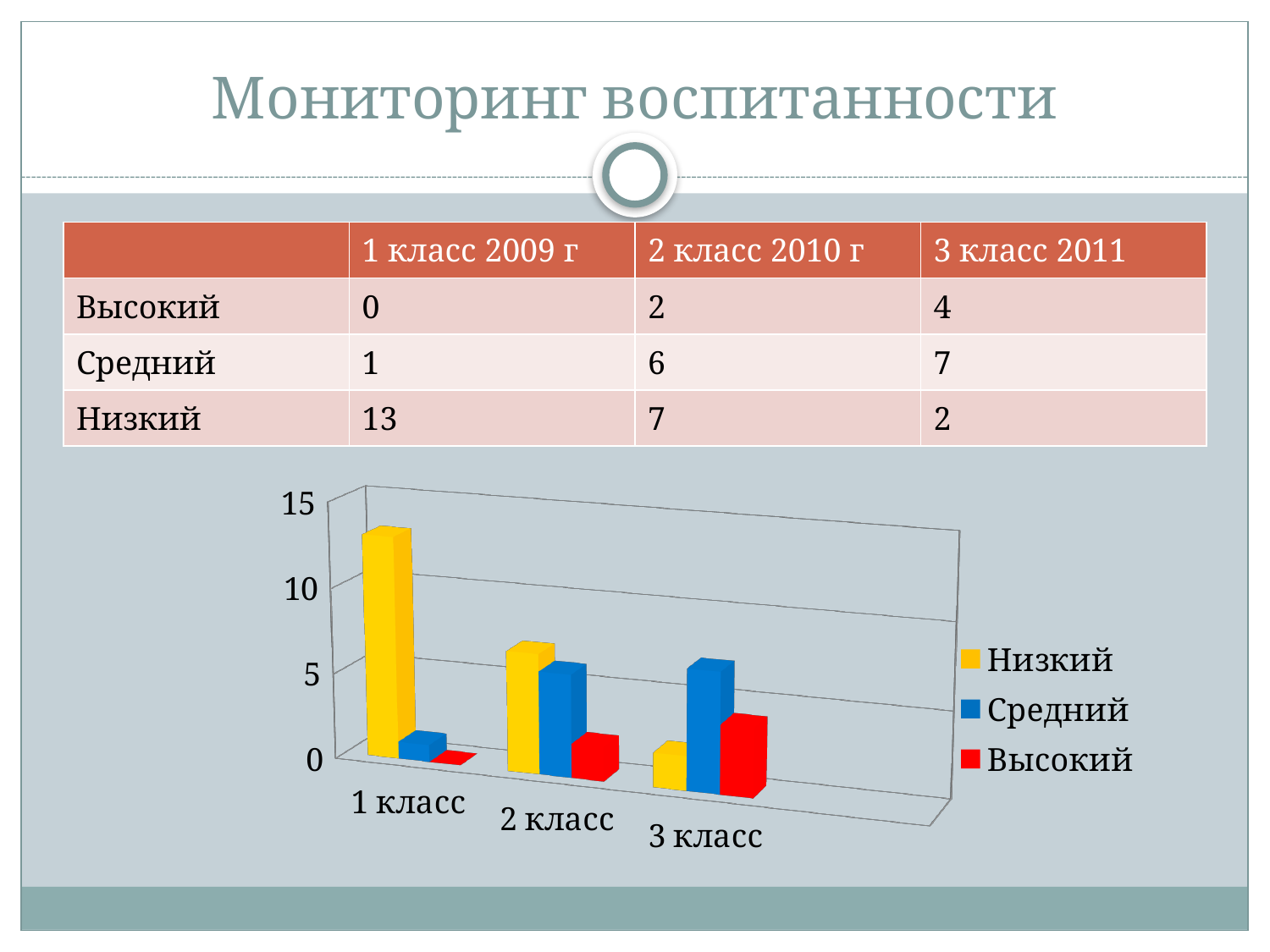
How many series does the chart legend list? 3 Do the Высокий values rise or fall from 1 класс to 3 класс? rise Which category has the highest value for Низкий? 1 класс Is the value for Низкий in 1 класс greater or less than 10? greater Which category has the lowest value for Высокий? 1 класс What is the difference between the Низкий values for 1 класс and 3 класс? 11 What is the value for Низкий in 1 класс? 13 How many categories are shown on the x axis of the chart? 3 What is the value for Высокий in 3 класс? 4 What kind of chart is shown on the slide? bar chart What is the value for Средний in 2 класс? 6 Which is larger in 3 класс, Средний or Низкий? Средний